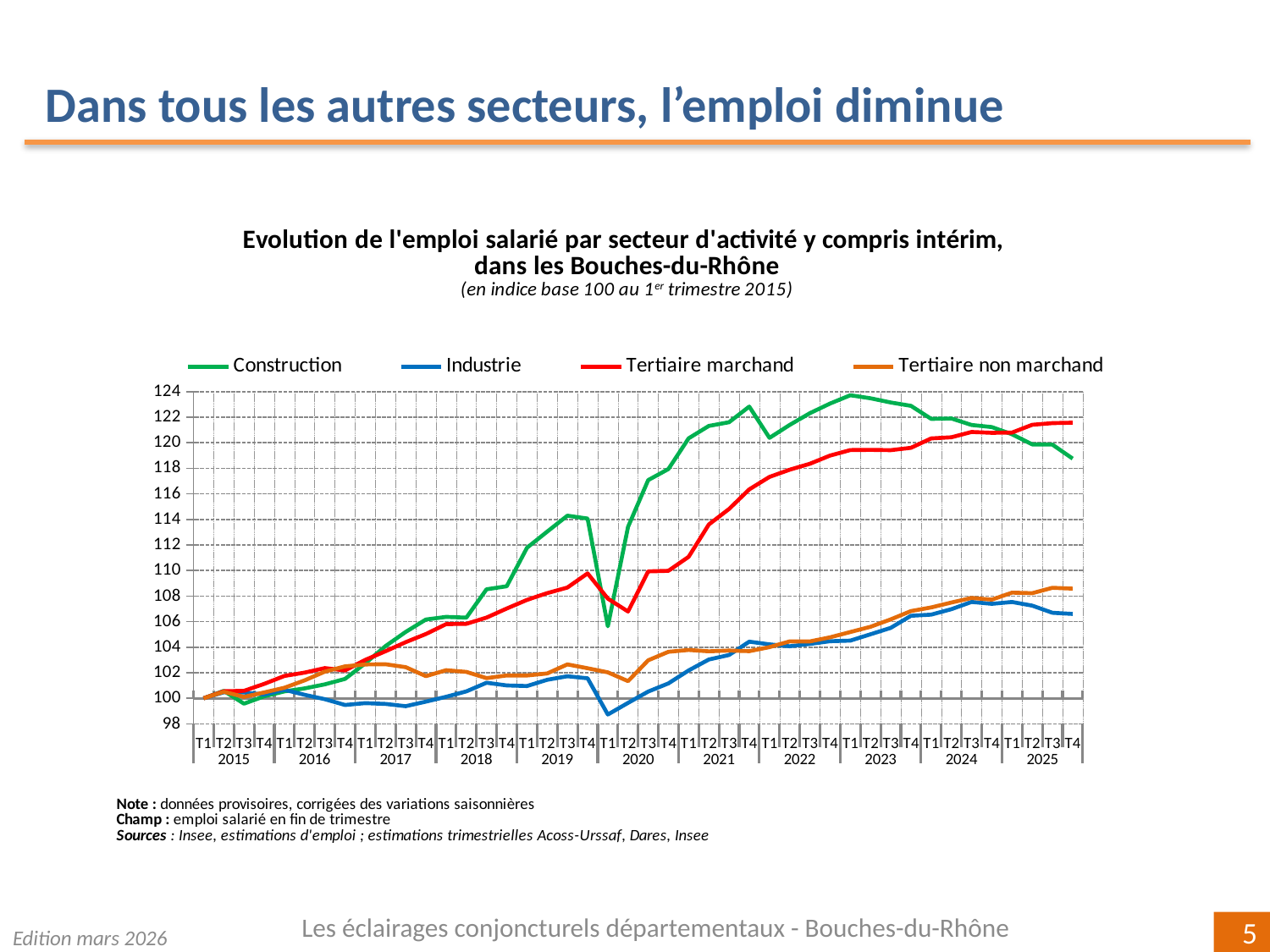
How many years are shown on the x axis? 11 Which series has the lowest value at T4 2025? Industrie At T4 2025, which is higher: Tertiaire marchand or Construction? Tertiaire marchand Which series are listed in the legend? Construction, Industrie, Tertiaire marchand, Tertiaire non marchand Is the value for Tertiaire marchand at T4 2025 greater or less than 120? greater Is the value for Industrie at T1 2020 greater or less than 100? less Which series reaches the highest index value anywhere on the chart? Construction What kind of chart is shown on the slide? line chart How many series does the legend list? 4 What is the index value of all four series at T1 2015? 100 Is the value for Construction at T1 2023 greater or less than 122? greater Does the Construction series rise or fall between T1 2023 and T4 2025? fall